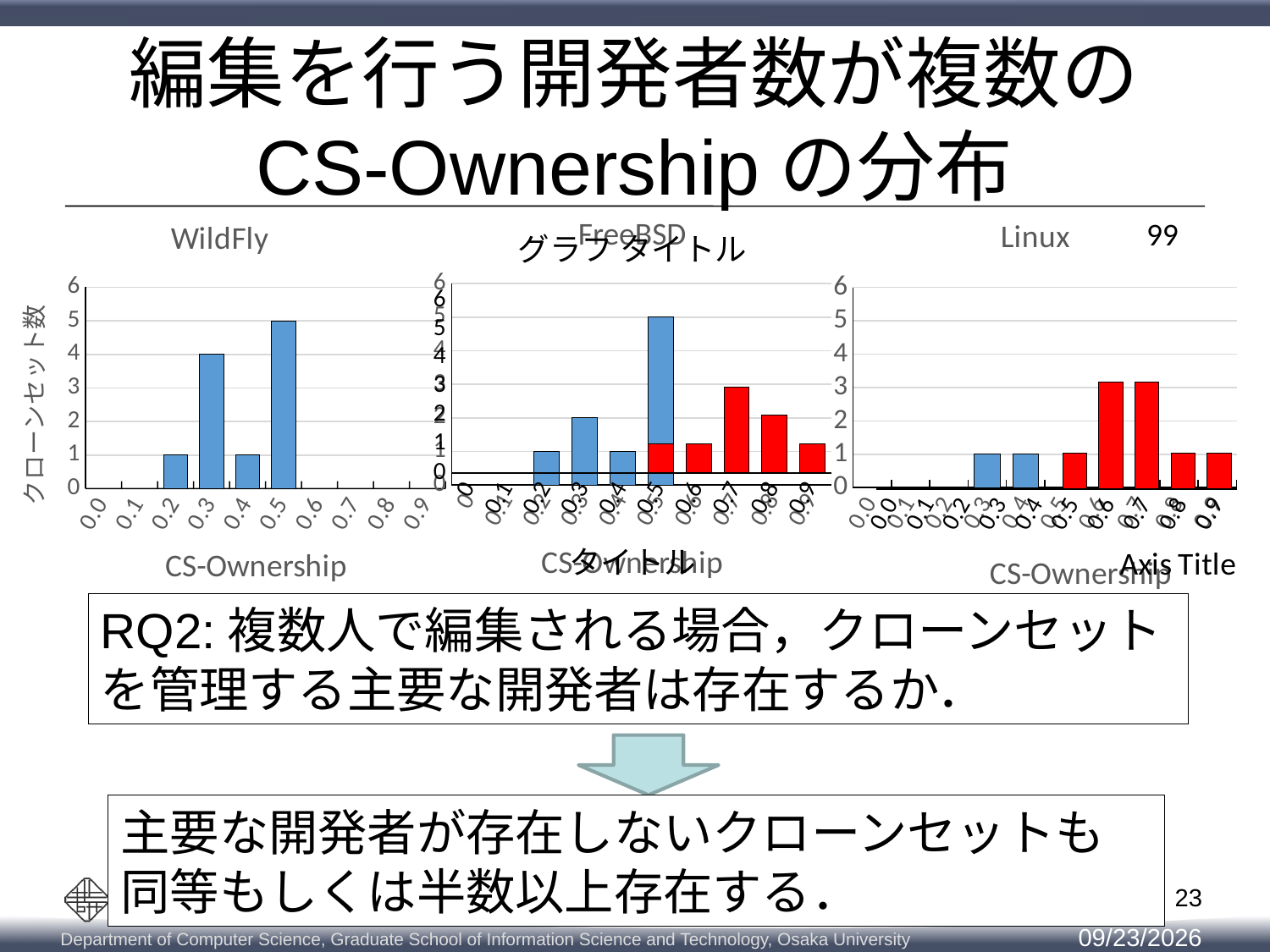
In the Linux chart, what colour are the bars for CS-Ownership values of 0.5 and above? red In the WildFly chart, what is the difference between the values for 0.5 and 0.3? 1 In the WildFly chart, what is the value for CS-Ownership 0.5? 5 In the WildFly chart, what is the label of the y axis? クローンセット数 In the FreeBSD chart, which CS-Ownership category has the tallest bar? 0.5 What kind of chart is the WildFly chart? bar chart In the WildFly chart, which CS-Ownership category has the highest value? 0.5 In the WildFly chart, how many CS-Ownership categories have a non-zero bar? 4 In the WildFly chart, what is the value for CS-Ownership 0.2? 1 In the Linux chart, what is the highest value reached by any bar? 3 In the WildFly chart, what is the value for CS-Ownership 0.3? 4 In the WildFly chart, which is larger, the value for 0.3 or the value for 0.4? 0.3